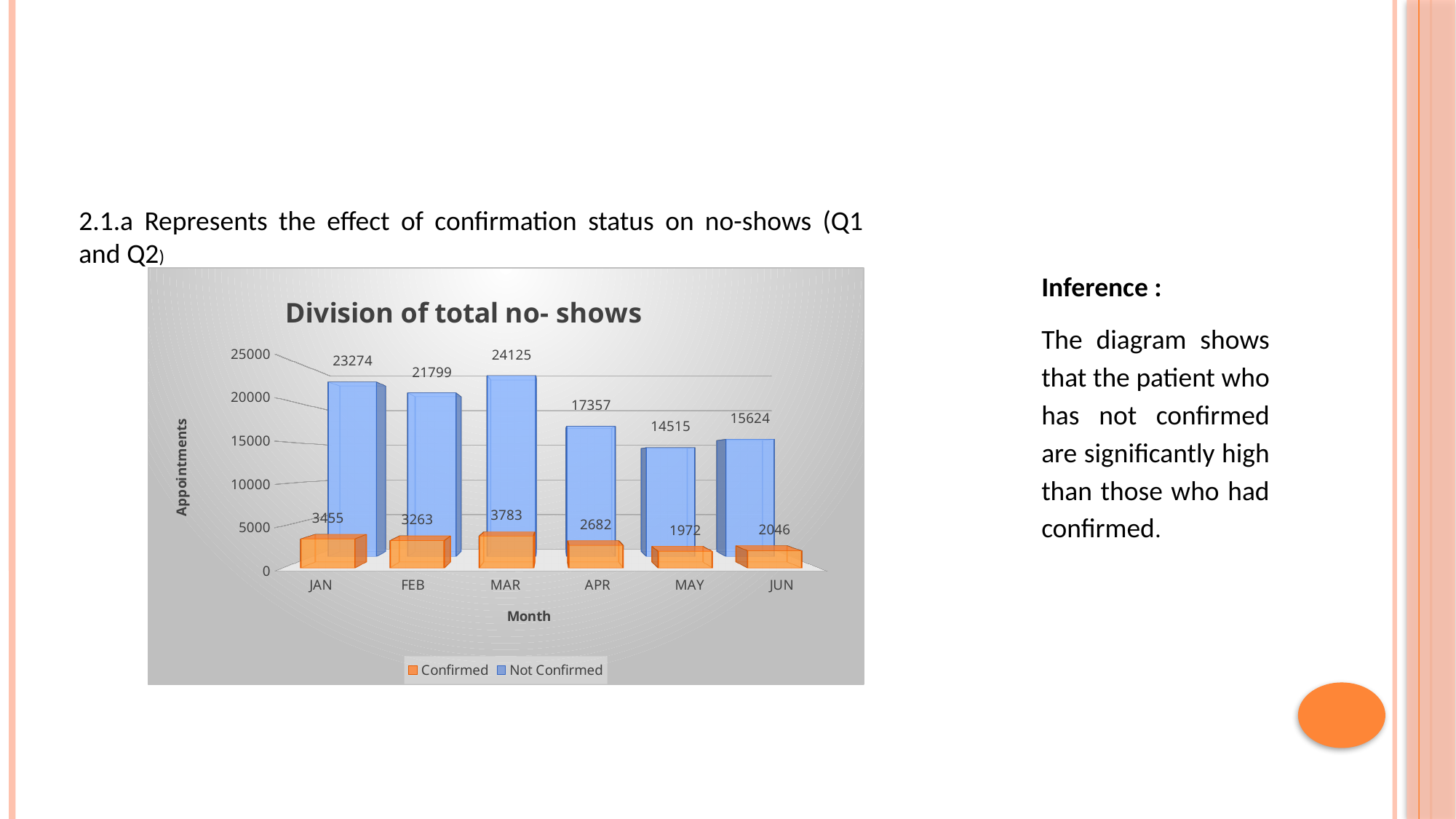
What is the Not Confirmed value for MAR? 24125 Which month has the highest Not Confirmed value? MAR What kind of chart is shown? bar chart What is the title of the chart? Division of total no- shows What is the difference between the Not Confirmed values for JAN and FEB? 1475 Which is larger, the Not Confirmed value for APR or for JUN? APR What is the Confirmed value for JAN? 3455 Is the Not Confirmed value for MAY greater or less than 15000? less How many series does the legend list? 2 How many months are shown on the x axis? 6 What is the Confirmed value for MAY? 1972 Which month has the lowest Confirmed value? MAY